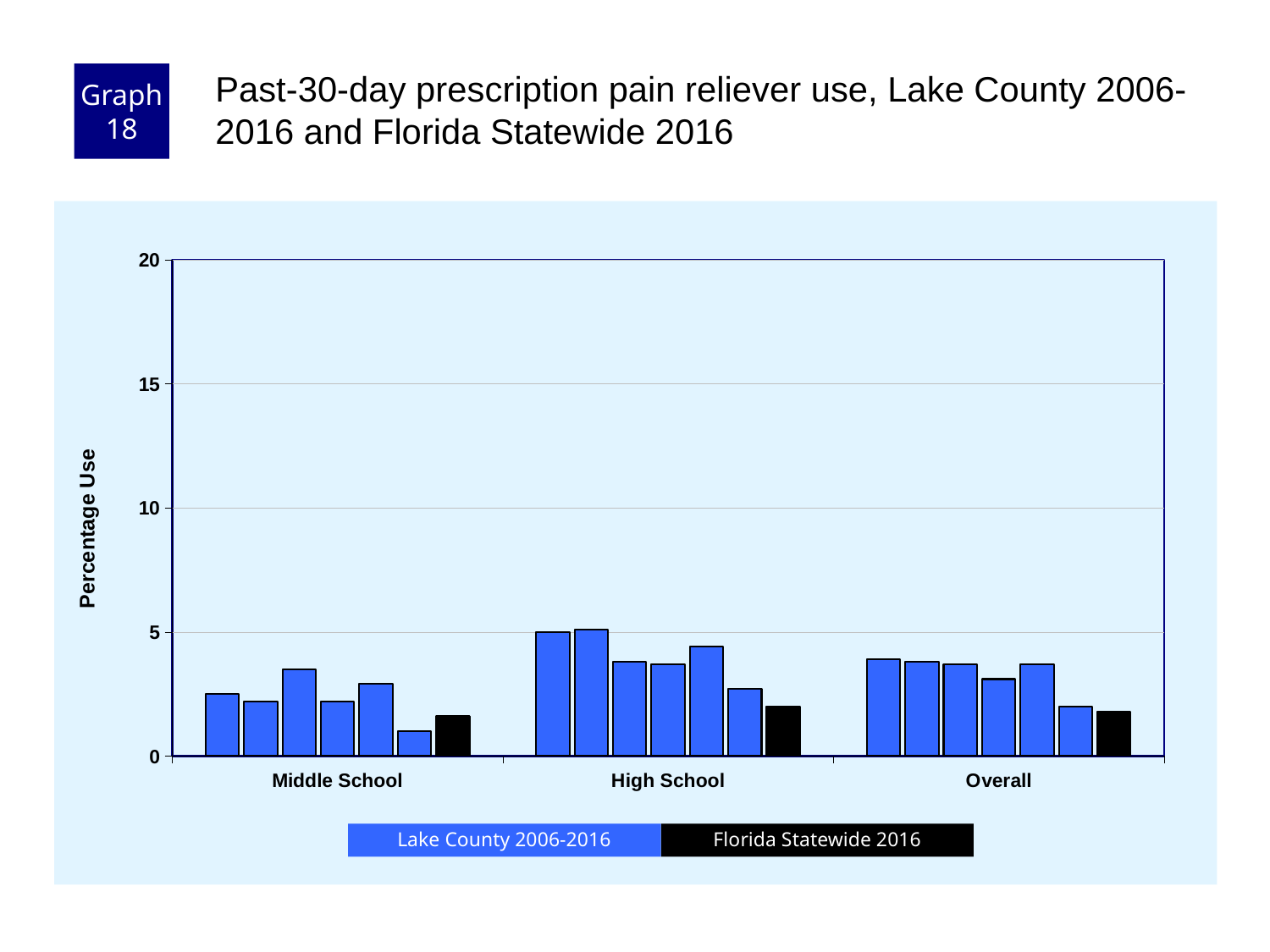
What is the label on the y axis? Percentage Use What kind of chart is shown on the slide? bar chart Is the Florida Statewide 2016 bar in the High School group greater or less than 5? less How many categories are shown on the x axis? 3 Is the value for Florida Statewide 2016 in the Middle School group greater or less than 5? less Which category contains the tallest bar in the chart? High School Which category contains the shortest bar in the chart? Middle School Are any of the bars in the chart greater than 10? No How many series does the legend list? 2 What is the highest value shown on the y axis? 20 Which colour represents Florida Statewide 2016 in the legend? black